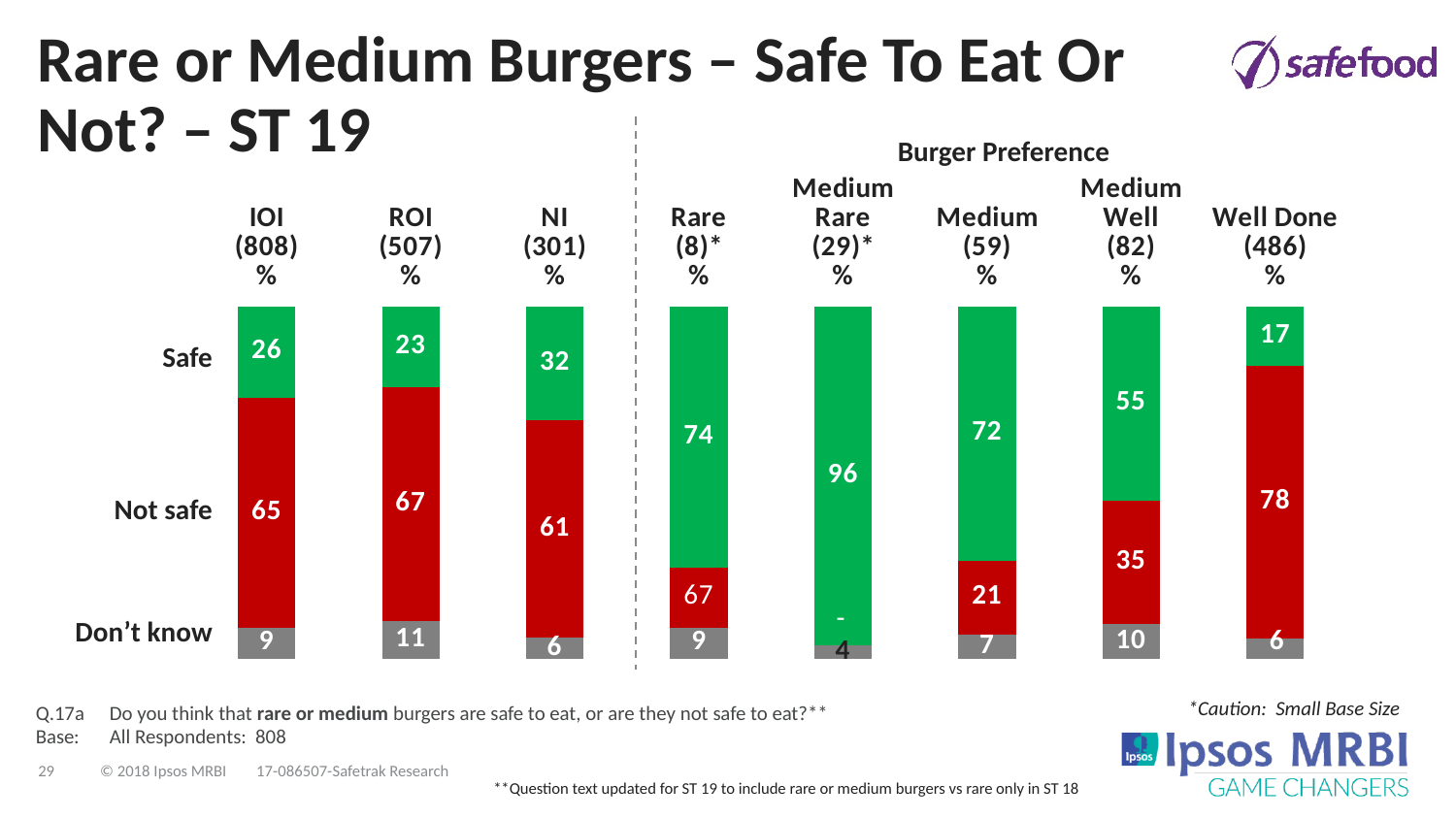
Among the burger preference groups, which has the highest 'Safe' value? Medium Rare (29)* What is the 'Don't know' value for the Medium Well (82) group? 10 What type of chart is shown on the slide? Stacked bar chart Among the burger preference groups, which has the lowest 'Safe' value? Well Done (486) What is the 'Not safe' value for ROI (507)? 67 What percentage of IOI respondents said rare or medium burgers are safe to eat? 26 What is the 'Don't know' value for NI (301)? 6 How many bars (groups) are shown in the chart? 8 Which has a larger 'Safe' value, NI (301) or ROI (507)? NI (301) What is the 'Safe' value for the Medium Rare (29)* group? 96 How many response categories (series) are stacked in each bar? 3 How much higher is the 'Not safe' value for Well Done (486) than for Medium (59)? 57